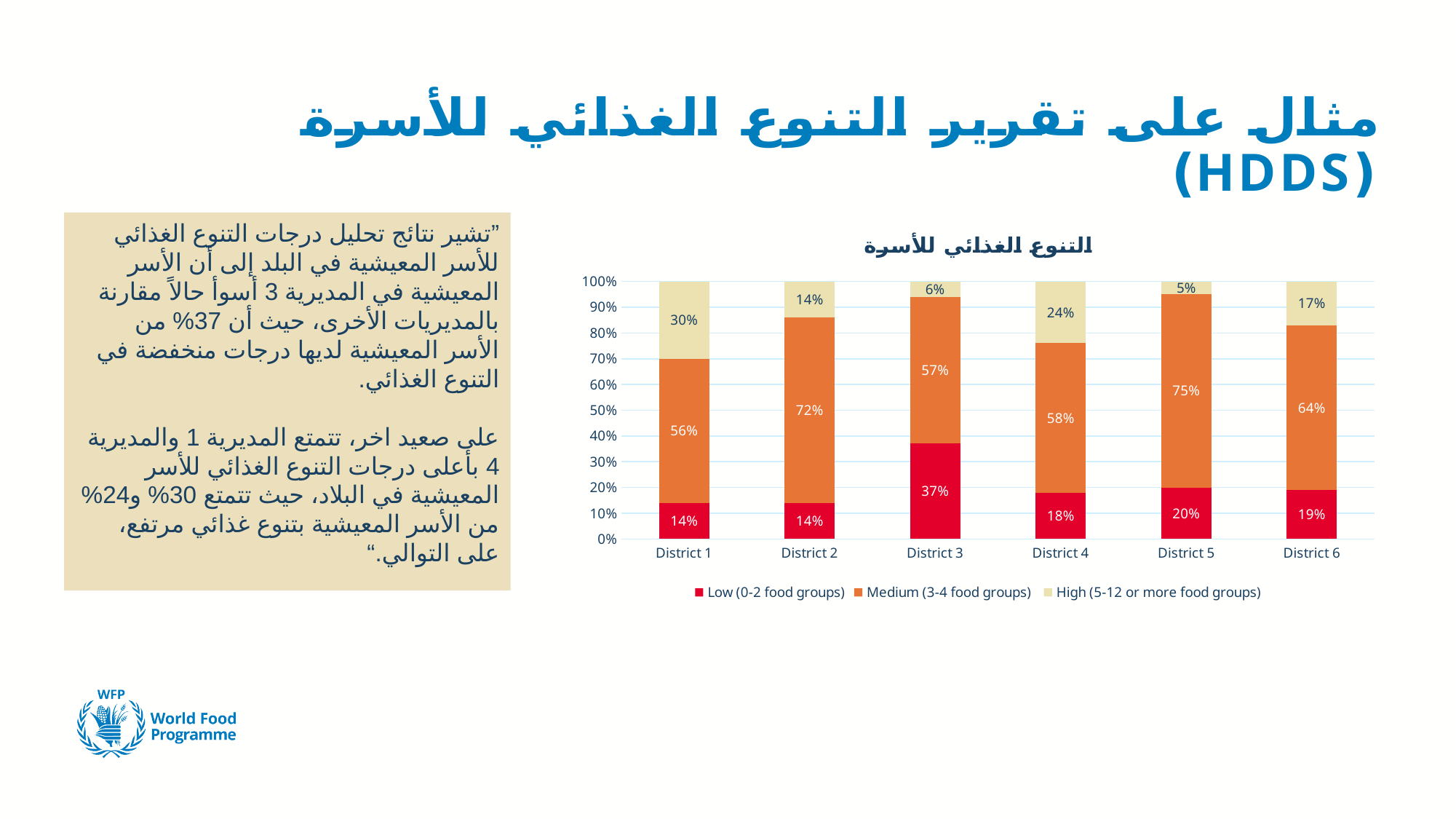
How many districts are shown on the x axis? 6 What is the difference between the High (5-12 or more food groups) values for District 1 and District 4? 6% What kind of chart is shown on the slide? Stacked bar chart What is the High (5-12 or more food groups) value for District 1? 30% What is the Low (0-2 food groups) value for District 3? 37% How many series does the legend list? 3 Which district has the lowest High (5-12 or more food groups) share? District 5 Which colour represents the Low (0-2 food groups) series? Red What is the total of the stacked bar for District 4? 100% Which district has the highest Low (0-2 food groups) share? District 3 What is the Medium (3-4 food groups) value for District 5? 75% Which is larger, the Medium (3-4 food groups) value for District 2 or for District 6? District 2